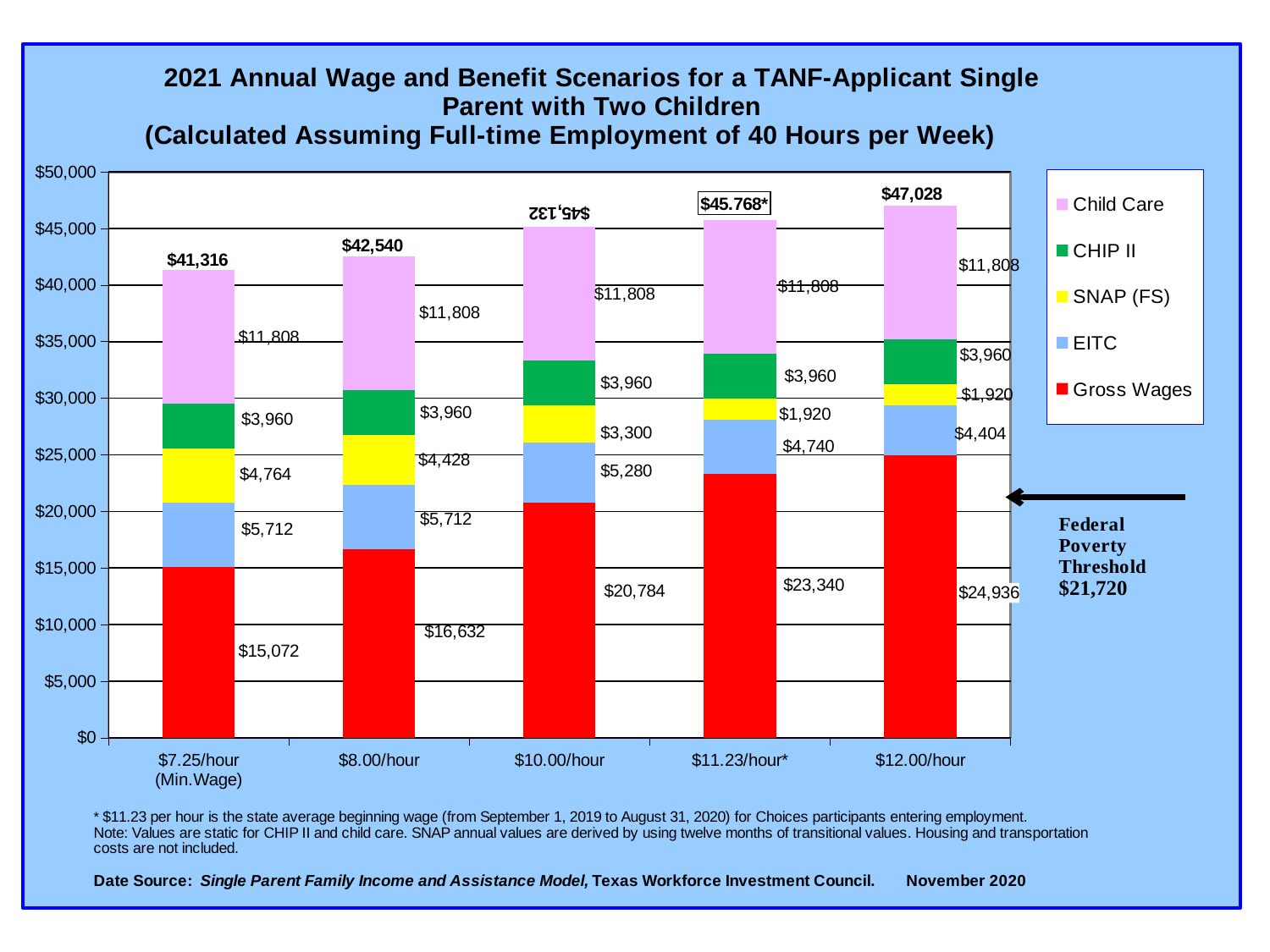
How many series does the legend list? 5 Which scenario has the lowest Gross Wages value? $7.25/hour (Min.Wage) What Federal Poverty Threshold value is marked on the chart? $21,720 Which scenario has the larger SNAP (FS) value, $7.25/hour or $8.00/hour? $7.25/hour What is the EITC value for the $12.00/hour scenario? $4,404 Do the Gross Wages values rise or fall as the hourly wage increases along the x axis? Rise How many hourly wage categories are shown on the x axis? 5 What is the total of the stacked bar for the $8.00/hour scenario? $42,540 Which hourly wage scenario has the highest total annual wage and benefits? $12.00/hour What is the Gross Wages value for the $10.00/hour scenario? $20,784 What is the difference in Gross Wages between the $12.00/hour and $7.25/hour scenarios? $9,864 What kind of chart is shown on the slide? Stacked bar chart